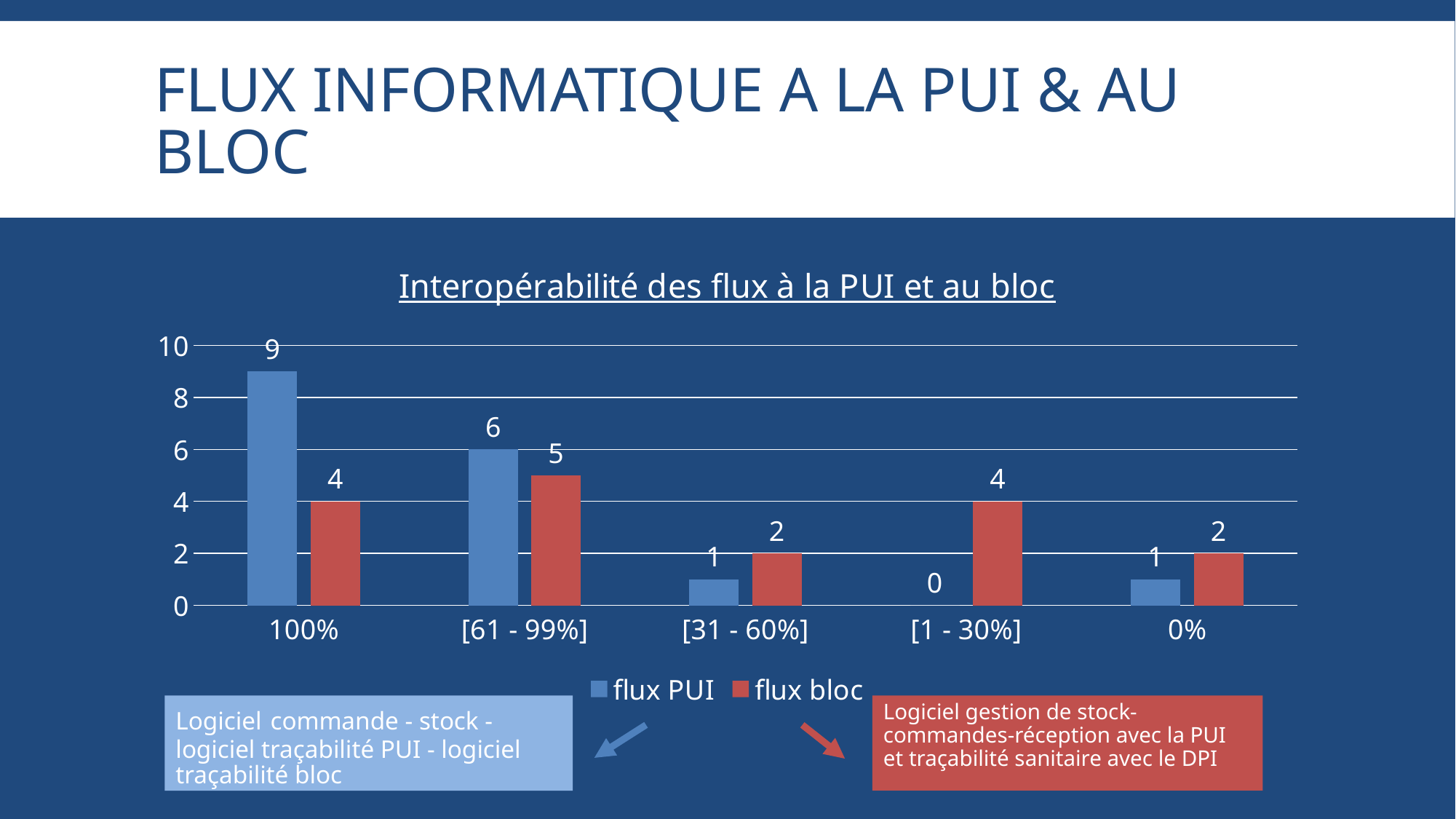
What kind of chart is shown on the slide? bar chart What is the value of flux PUI for the [1 - 30%] category? 0 What is the difference between flux PUI and flux bloc for the 100% category? 5 What is the title of the chart? Interopérabilité des flux à la PUI et au bloc How many categories are shown on the x axis? 5 Which category has the lowest flux PUI value? [1 - 30%] What is the value of flux bloc for the 0% category? 2 What is the value of flux bloc for the [61 - 99%] category? 5 How many series does the legend list? 2 Which category has the highest flux PUI value? 100% What is the value of flux PUI for the 100% category? 9 For the [31 - 60%] category, which series has the larger value, flux PUI or flux bloc? flux bloc